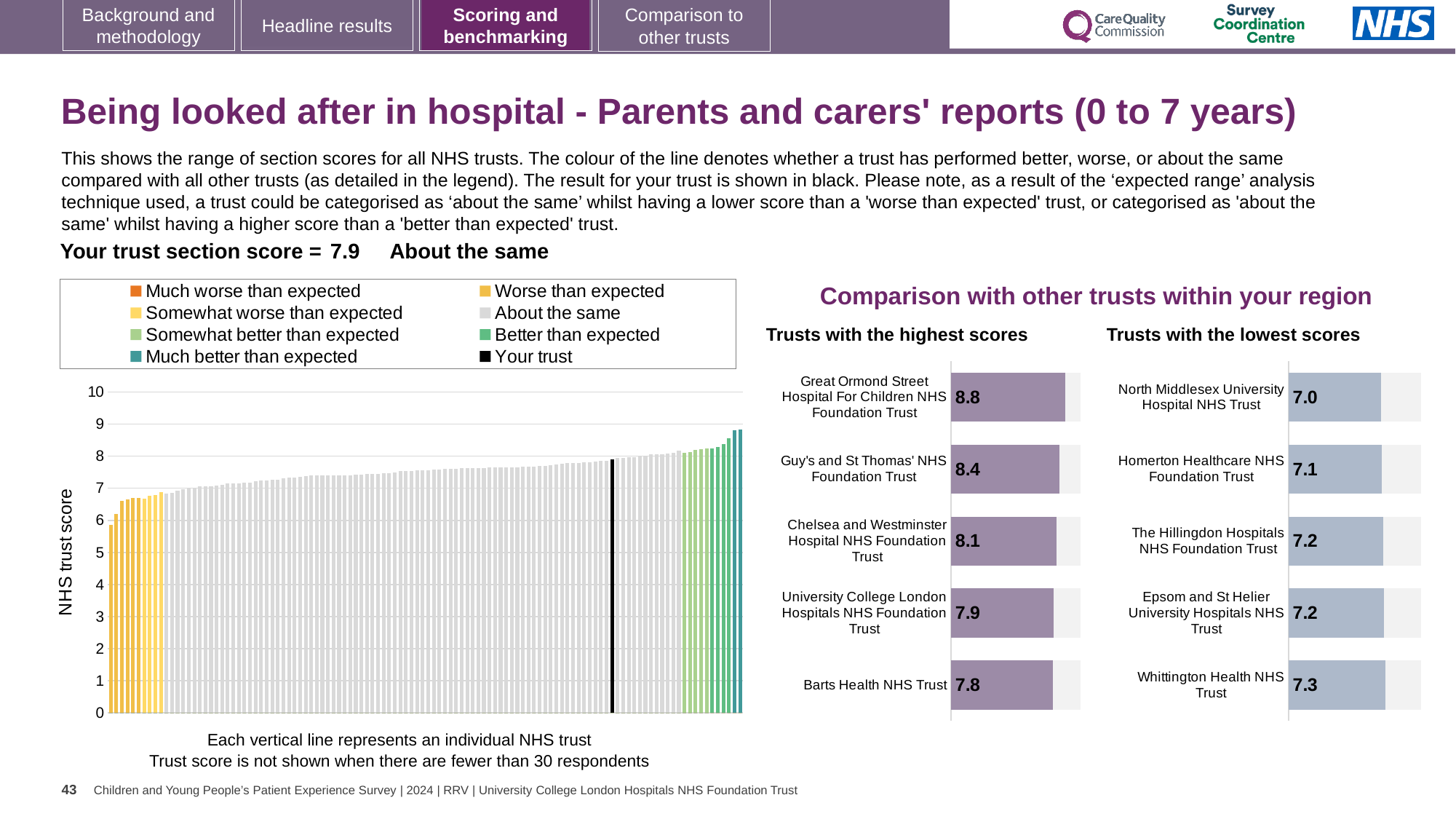
In the main 'NHS trust score' chart on the left, do the bar values rise or fall from left to right? rise In the 'Trusts with the lowest scores' chart, what is the difference between the scores of Whittington Health NHS Trust and North Middlesex University Hospital NHS Trust? 0.3 In the main 'NHS trust score' chart on the left, is the value of the tallest bar greater or less than 8? greater How many entries does the legend of the main 'NHS trust score' chart on the left list? 8 In the 'Trusts with the highest scores' chart, what is the difference between the scores of Great Ormond Street Hospital For Children NHS Foundation Trust and Barts Health NHS Trust? 1.0 In the 'Trusts with the highest scores' chart, which trust has the lowest score? Barts Health NHS Trust How many trusts are shown in the 'Trusts with the lowest scores' chart? 5 In the 'Trusts with the highest scores' chart, what is the score for Barts Health NHS Trust? 7.8 In the 'Trusts with the lowest scores' chart, which trust has the highest score? Whittington Health NHS Trust In the 'Trusts with the lowest scores' chart, what is the score for North Middlesex University Hospital NHS Trust? 7.0 In the 'Trusts with the highest scores' chart, what is the score for Great Ormond Street Hospital For Children NHS Foundation Trust? 8.8 In the 'Trusts with the highest scores' chart, which has a higher score: Guy's and St Thomas' NHS Foundation Trust or Chelsea and Westminster Hospital NHS Foundation Trust? Guy's and St Thomas' NHS Foundation Trust